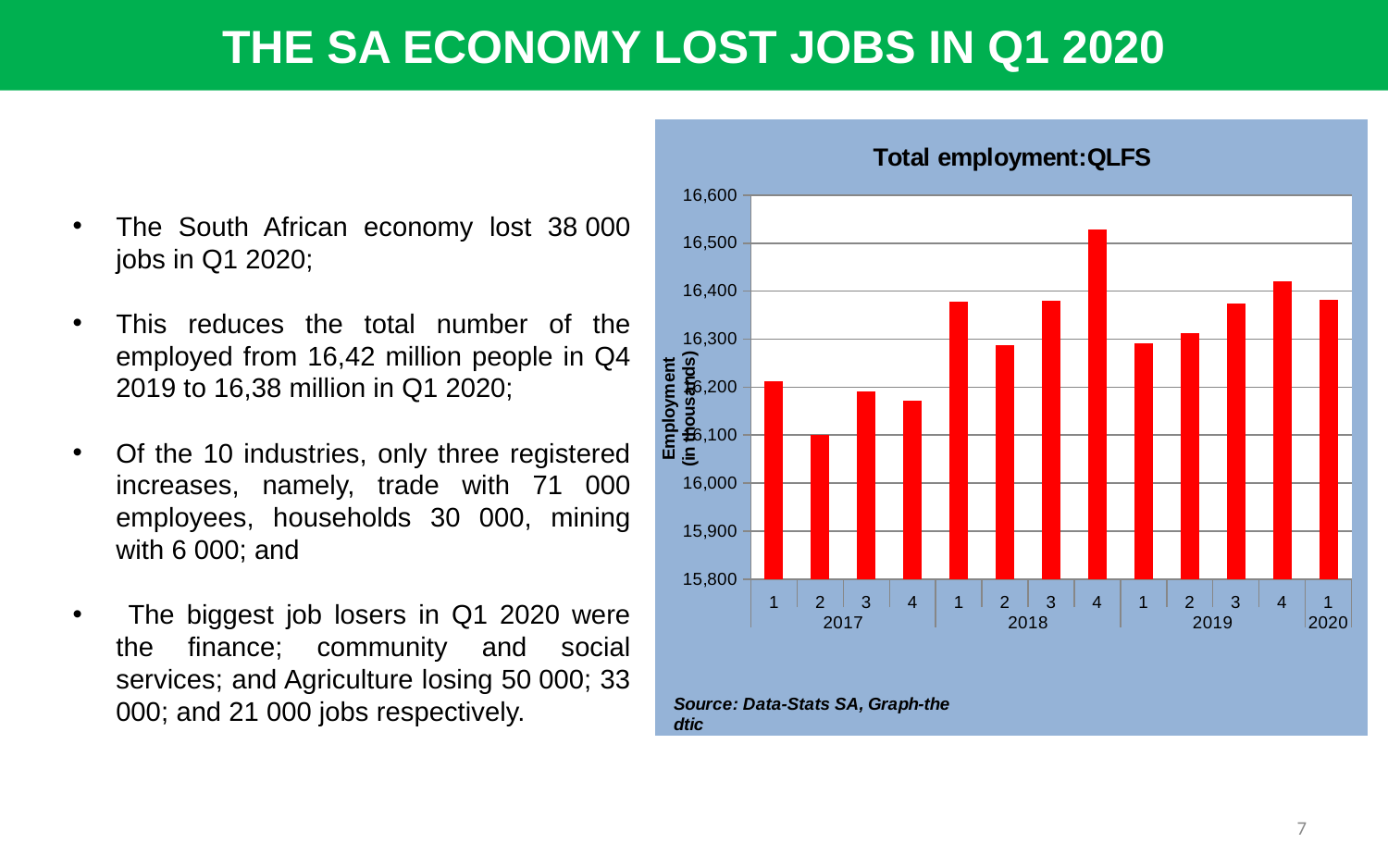
How many bars (quarters) are plotted in the chart? 13 Is the value for Q1 2018 greater or less than 16,300? greater What kind of chart is shown on the slide? bar chart Is the value for Q1 2020 greater or less than 16,300? greater What is the label on the vertical axis of the chart? Employment (in thousands) Which quarter has the highest total employment in the chart? Q4 2018 Which is larger, the value for Q4 2018 or the value for Q1 2019? Q4 2018 Is the value for Q4 2018 greater or less than 16,500? greater Which quarter has the lowest total employment in the chart? Q2 2017 Which is larger, the value for Q4 2019 or the value for Q1 2020? Q4 2019 What is the title of the chart? Total employment:QLFS